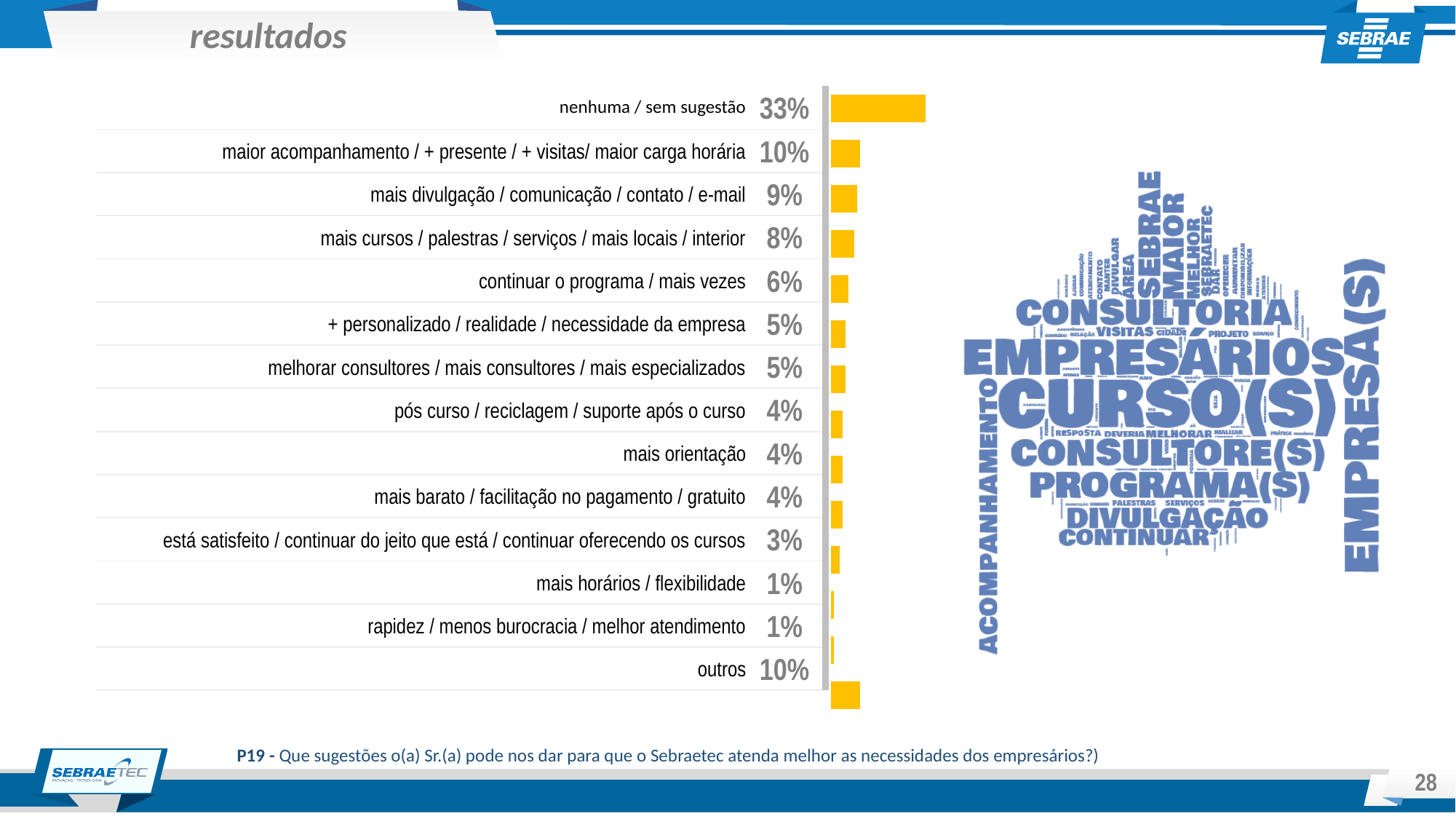
What percentage is shown for "nenhuma / sem sugestão"? 33% Which is larger: "maior acompanhamento / + presente / + visitas/ maior carga horária" or "mais orientação"? maior acompanhamento / + presente / + visitas/ maior carga horária What is the value for "outros"? 10% What type of chart is shown on the slide? bar chart What is the value for "mais divulgação / comunicação / contato / e-mail"? 9% Which category has the highest percentage? nenhuma / sem sugestão What percentage is shown for "continuar o programa / mais vezes"? 6% What percentage is shown for "mais horários / flexibilidade"? 1% What is the difference between "nenhuma / sem sugestão" and "outros"? 23% What colour are the bars in the chart? yellow How many categories are shown in the bar chart? 14 What is the difference between "mais cursos / palestras / serviços / mais locais / interior" and "pós curso / reciclagem / suporte após o curso"? 4%